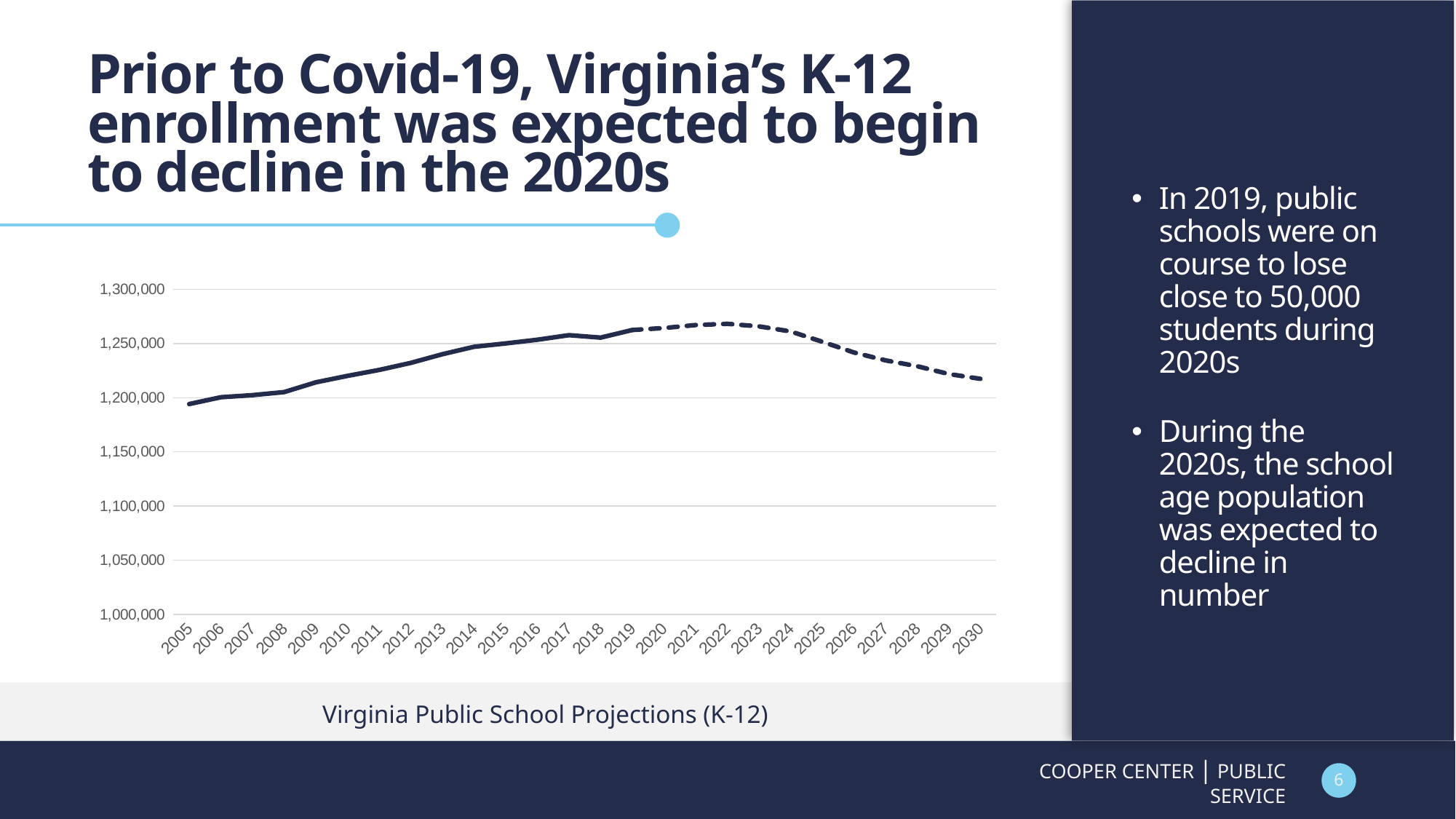
Is the value for 2022 greater or less than 1,250,000? greater Do the values rise or fall from 2005 to 2019? rise Is the value for 2005 greater or less than 1,200,000? less What is the title of the chart? Virginia Public School Projections (K-12) How many years are shown along the x axis of the chart? 26 Is the value for 2014 greater or less than 1,200,000? greater Which year has the lowest value on the chart? 2005 Which is larger, the value for 2019 or the value for 2005? 2019 Do the values rise or fall from 2023 to 2030? fall What kind of chart is shown on the slide? line chart From which year onward is the line drawn as a dashed line? 2019